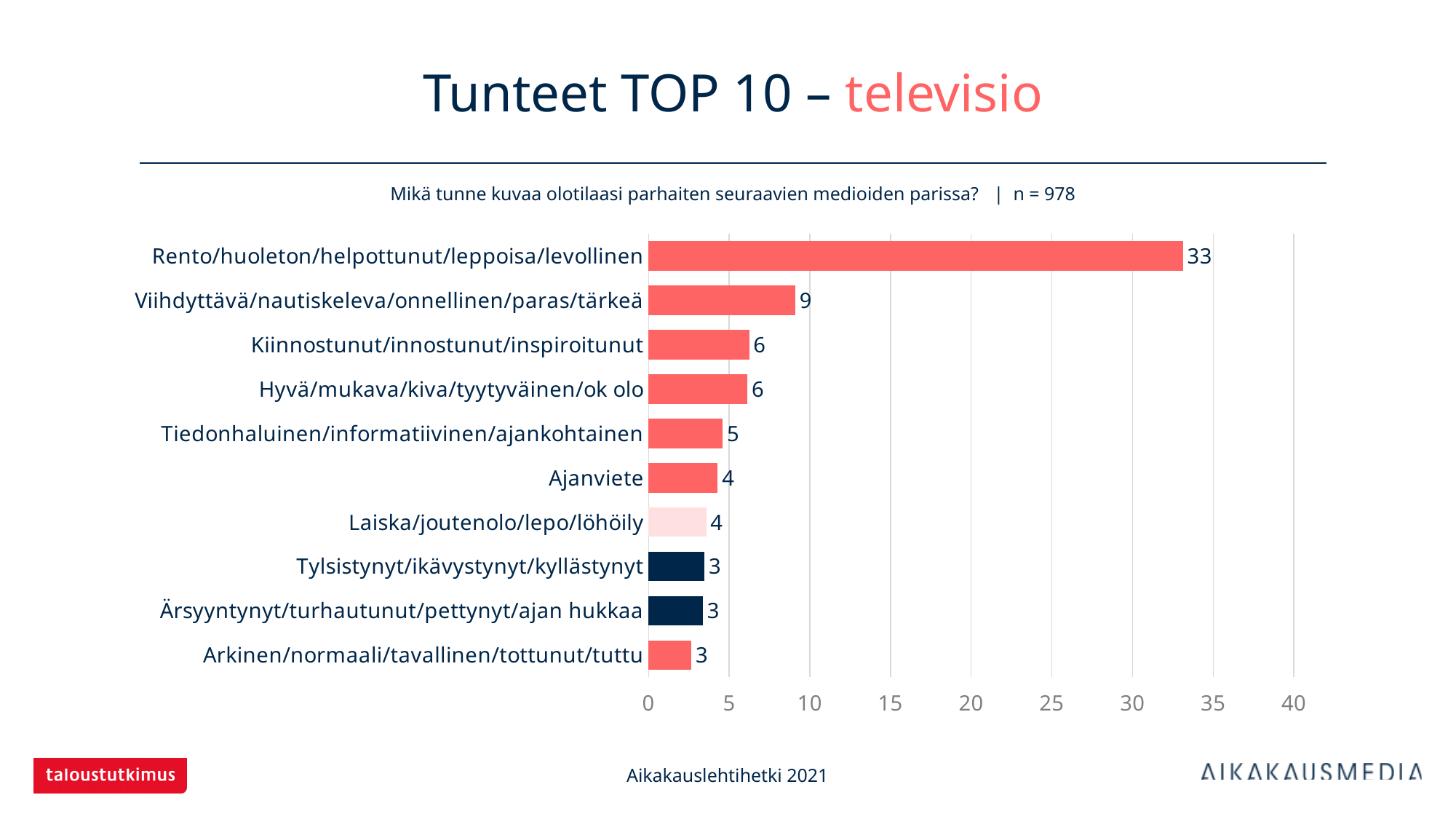
Is the value for Rento/huoleton/helpottunut/leppoisa/levollinen greater or less than 30? greater What kind of chart is shown on the slide? bar chart What is the value for Tiedonhaluinen/informatiivinen/ajankohtainen? 5 What is the value for Ajanviete? 4 Which is larger, the value for Kiinnostunut/innostunut/inspiroitunut or the value for Ajanviete? Kiinnostunut/innostunut/inspiroitunut What is the difference between the values for Rento/huoleton/helpottunut/leppoisa/levollinen and Viihdyttävä/nautiskeleva/onnellinen/paras/tärkeä? 24 What is the value for Viihdyttävä/nautiskeleva/onnellinen/paras/tärkeä? 9 What is the title of the chart? Tunteet TOP 10 – televisio What is the sample size (n) stated on the slide? 978 What is the value for Rento/huoleton/helpottunut/leppoisa/levollinen? 33 How many categories are shown in the chart? 10 Which category has the highest value? Rento/huoleton/helpottunut/leppoisa/levollinen